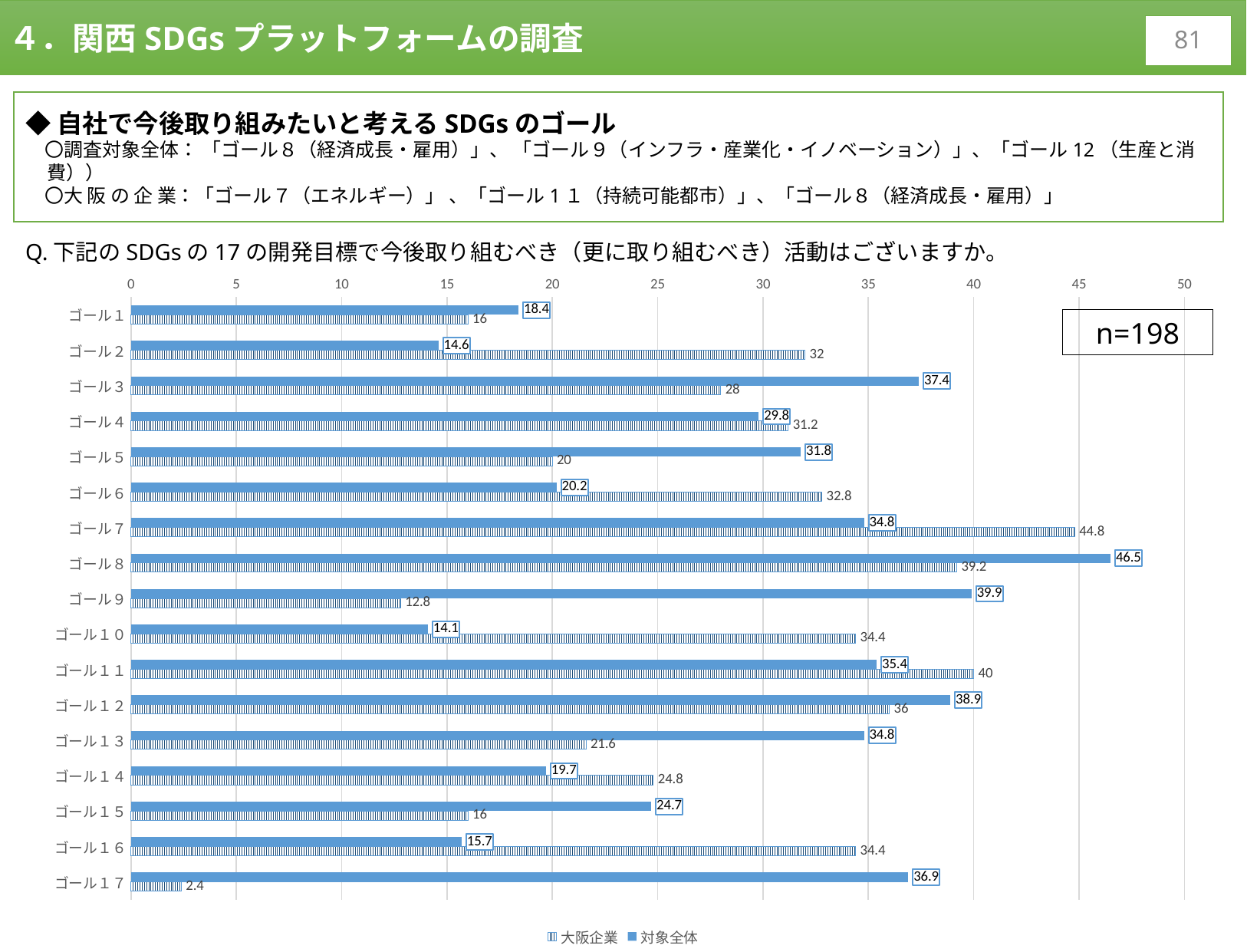
For ゴール２, which series has the larger value, 大阪企業 or 対象全体? 大阪企業 What is the value for 対象全体 for ゴール８? 46.5 What kind of chart is shown on the slide? bar chart Which category has the highest value for 対象全体? ゴール８ What sample size is shown in the box on the chart? n=198 What is the difference between the 対象全体 and 大阪企業 values for ゴール９? 27.1 Which category has the highest value for 大阪企業? ゴール７ What is the value for 大阪企業 for ゴール７? 44.8 How many series does the legend list? 2 Which category has the lowest value for 対象全体? ゴール１０ What is the value for 大阪企業 for ゴール１７? 2.4 How many categories are shown on the chart? 17